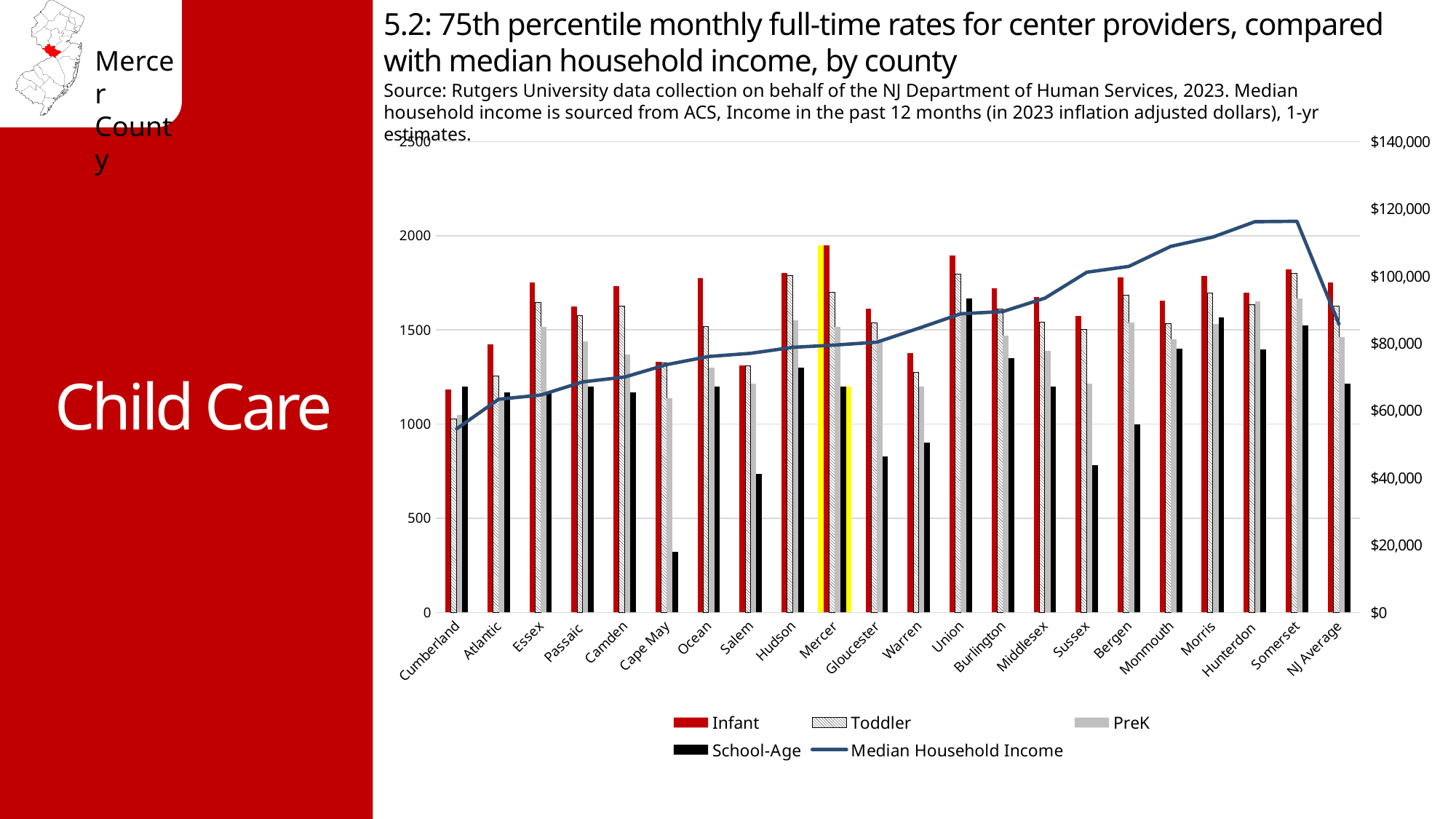
Is the Infant rate for Mercer greater or less than 1500? greater Is the Median Household Income for Cumberland greater or less than $80,000? less Which county has the lowest Infant rate? Cumberland Does the Median Household Income line generally rise or fall from Cumberland to Somerset? rise Is the School-Age rate for Cape May greater or less than 500? less Which county has the highest Infant rate? Mercer How many counties/categories are shown along the x axis of the chart? 22 How many series does the chart's legend list? 5 Which county has the lowest School-Age rate? Cape May Which is larger, the School-Age rate for Union or for Warren? Union What kind of chart is shown on the slide? bar chart with a line